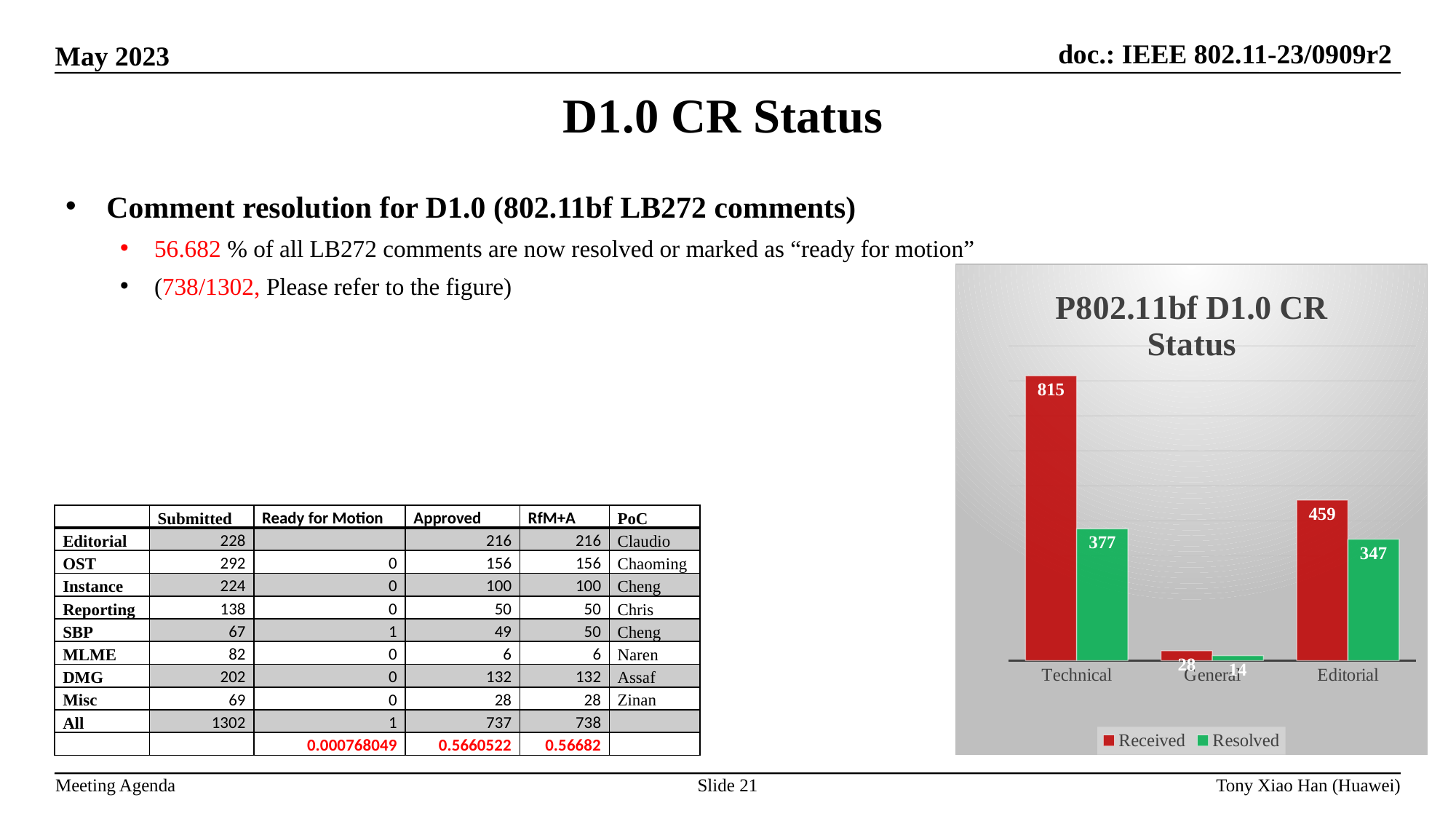
What is the Received value for Technical? 815 What is the Resolved value for Editorial? 347 What type of chart is shown on the slide? Bar chart How many categories are shown on the x axis of the chart? 3 Which category has the lowest Resolved value? General What is the Resolved value for General? 14 Which category has the highest Received value? Technical What is the difference between Received and Resolved for Editorial? 112 How many series does the chart legend list? 2 Which is larger, the Resolved value for Technical or the Resolved value for Editorial? Technical What is the Received value for Editorial? 459 What is the difference between Received and Resolved for Technical? 438